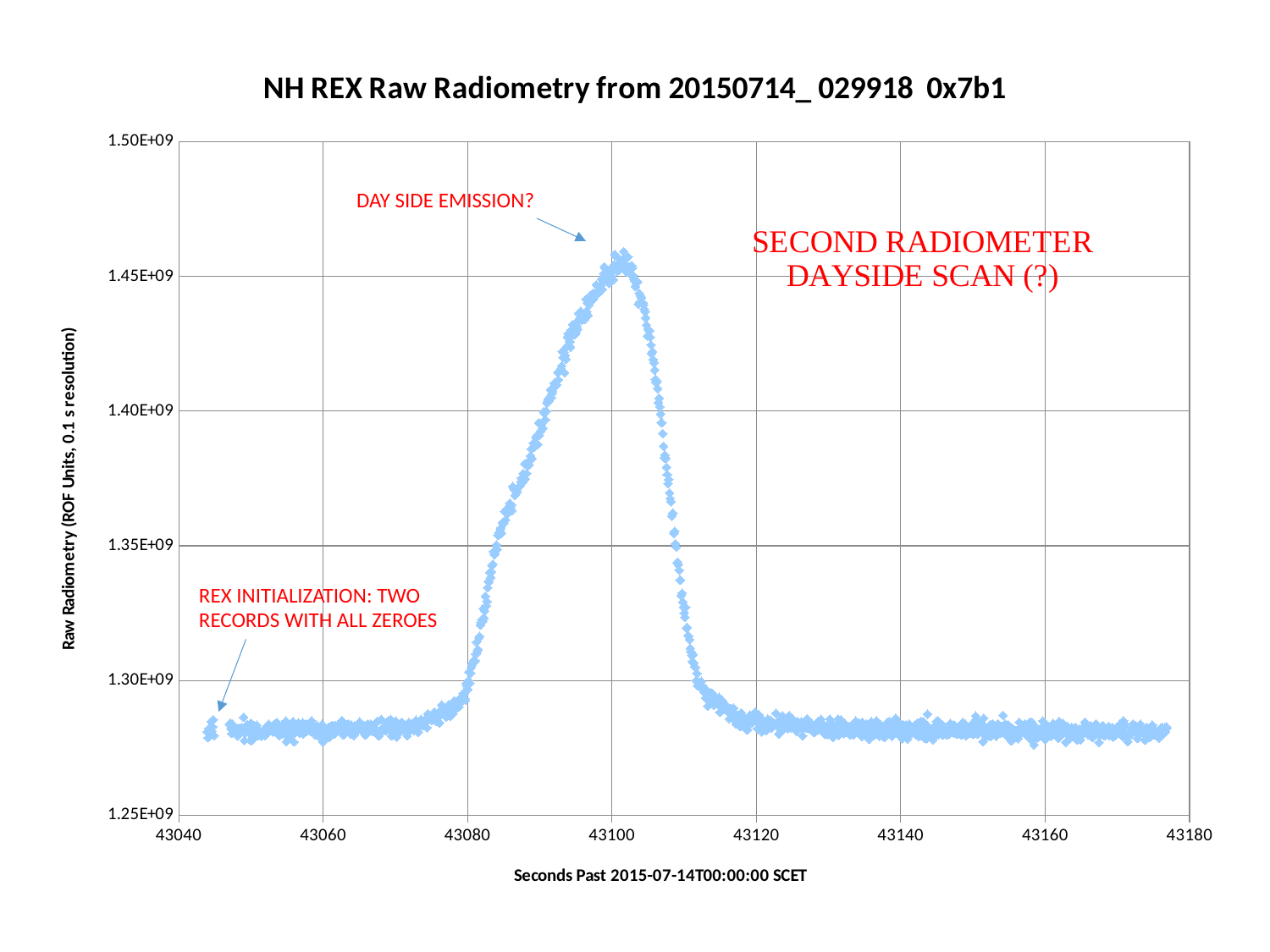
Is the value at x = 43140 greater or less than 1.30E+09? less What kind of chart is shown on the slide? scatter chart Is the peak value of the plotted data greater or less than 1.40E+09? greater What is the title of the chart? NH REX Raw Radiometry from 20150714_ 029918 0x7b1 Do the values rise or fall as x goes from 43100 to 43120? fall Is the value at x = 43100 greater or less than 1.35E+09? greater What is the lowest value shown on the y-axis? 1.25E+09 What is the label of the y-axis? Raw Radiometry (ROF Units, 0.1 s resolution) Do the values rise or fall as x goes from 43080 to 43100? rise Is the value at x = 43100 larger or smaller than the value at x = 43160? larger Which labeled x-axis tick is closest to the peak of the plotted data? 43100